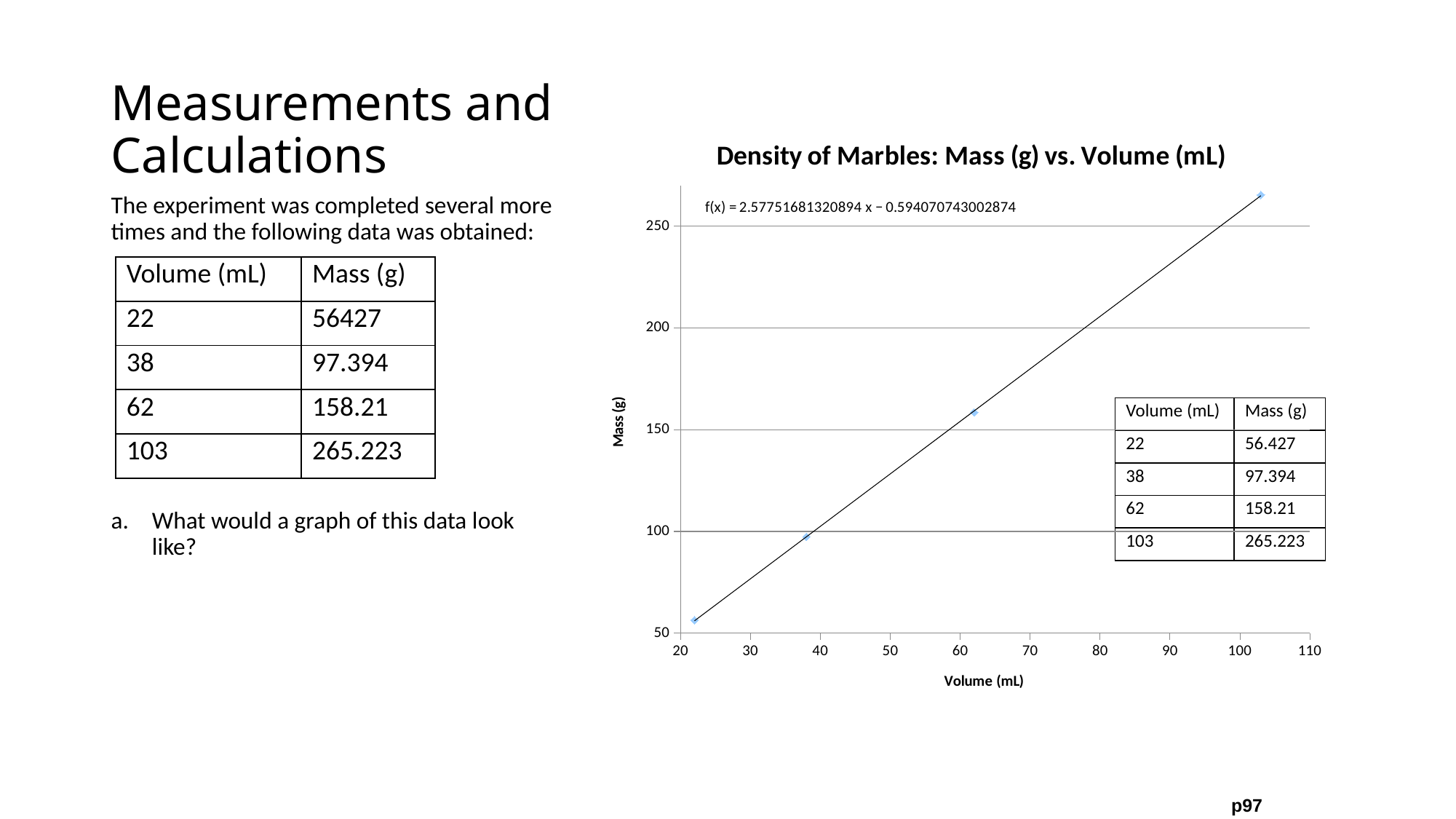
What is the label of the x axis on the chart? Volume (mL) Is the mass at a volume of 62 mL greater or less than 150? greater Which volume has the lowest mass on the chart? 22 Which volume has the highest mass on the chart? 103 According to the data table on the chart, what is the mass (g) at a volume of 62 mL? 158.21 According to the data table on the chart, what is the mass (g) at a volume of 38 mL? 97.394 According to the data table on the chart, what is the mass (g) at a volume of 103 mL? 265.223 What kind of chart is shown on the slide? scatter chart What is the title of the chart? Density of Marbles: Mass (g) vs. Volume (mL) Does mass rise or fall as volume increases along the x axis? rise Is the mass at a volume of 103 mL greater or less than 250? greater How many data points are plotted on the chart? 4